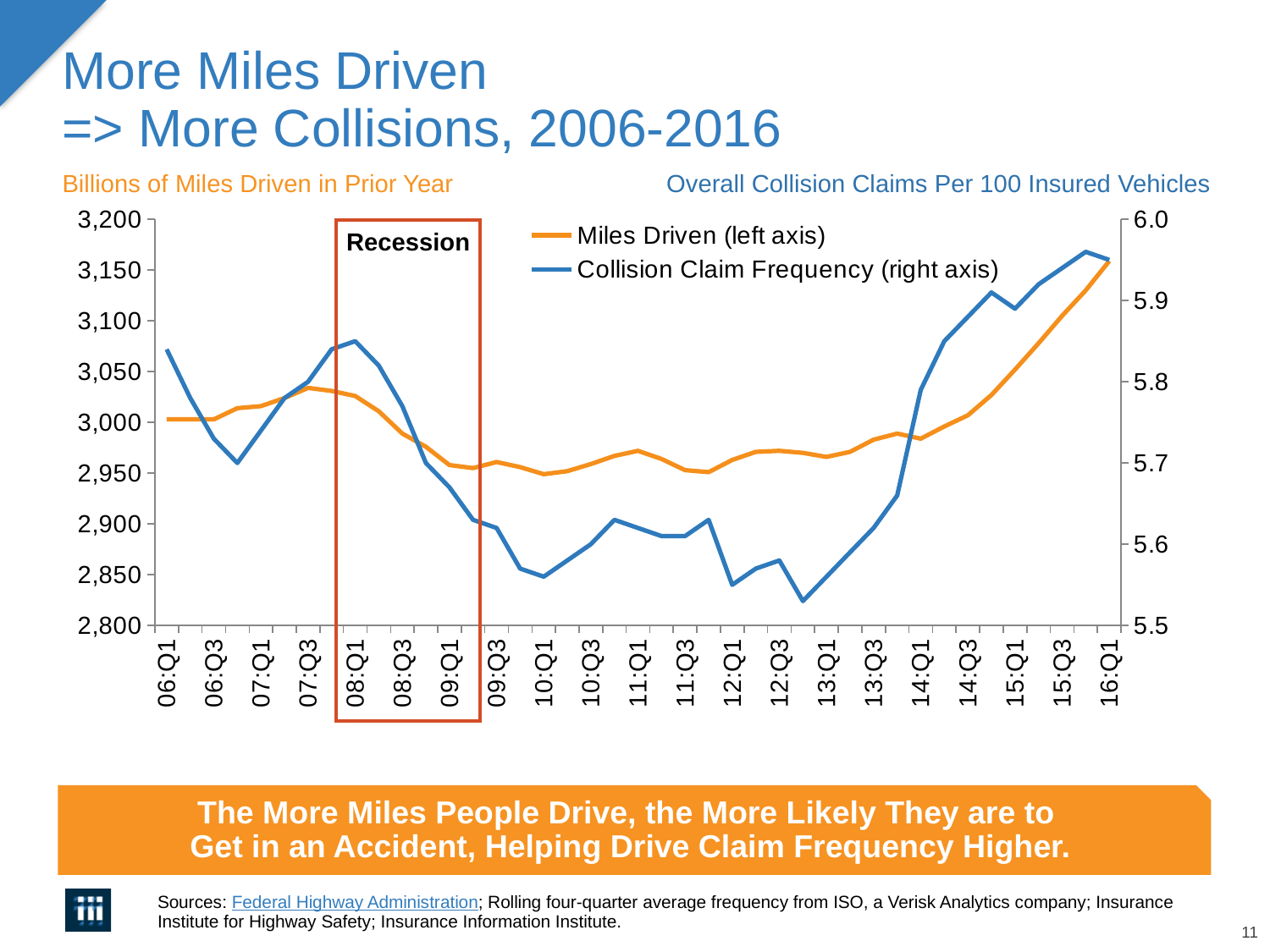
Is the value for Collision Claim Frequency at 12:Q1 greater or less than 5.6? less At which quarter is Miles Driven highest? 16:Q1 What kind of chart is shown on the slide? line chart Which period does the red 'Recession' box span on the x axis? 08:Q1 to 09:Q1 How many series does the legend list? 2 Does Miles Driven rise or fall from 13:Q1 to 16:Q1? rise Which series is plotted against the right axis? Collision Claim Frequency Is the value for Miles Driven at 10:Q1 greater or less than 3,000? less Does Collision Claim Frequency rise or fall from 08:Q1 to 10:Q1? fall Is the value for Collision Claim Frequency at 16:Q1 greater or less than 5.9? greater Which is larger, Collision Claim Frequency at 08:Q1 or at 10:Q1? 08:Q1